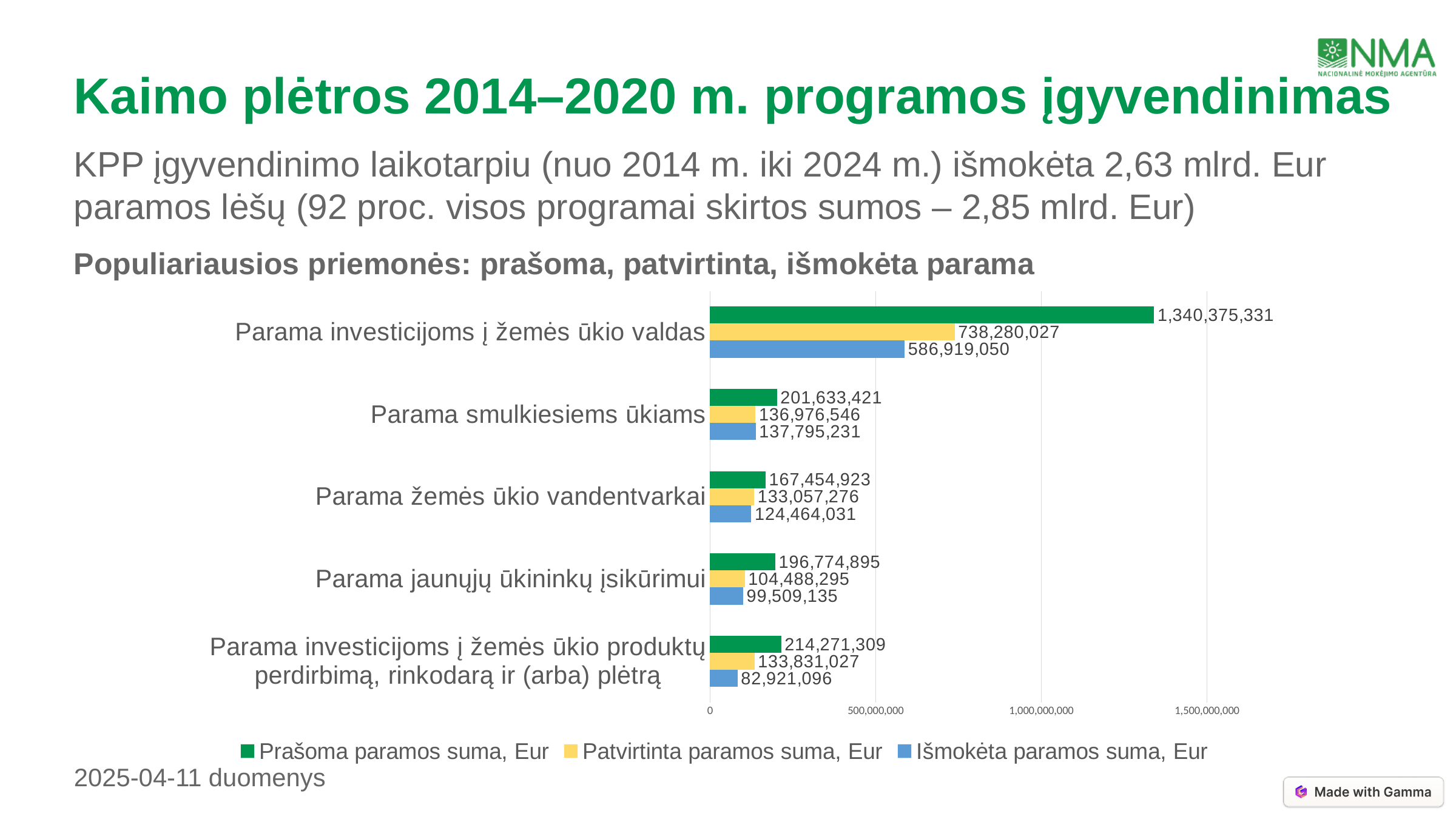
What type of chart is shown on the slide? bar chart What is the Patvirtinta paramos suma, Eur for Parama žemės ūkio vandentvarkai? 133,057,276 Is the Patvirtinta paramos suma for Parama investicijoms į žemės ūkio valdas greater or less than 1,000,000,000? less What is the Prašoma paramos suma, Eur for Parama investicijoms į žemės ūkio valdas? 1,340,375,331 Which colour represents the Išmokėta paramos suma, Eur series in the chart? blue How many series does the chart legend list? 3 Which category has the highest Prašoma paramos suma, Eur? Parama investicijoms į žemės ūkio valdas How many categories (measures) are shown in the chart? 5 What is the Išmokėta paramos suma, Eur for Parama jaunųjų ūkininkų įsikūrimui? 99,509,135 What is the difference between the Prašoma and Patvirtinta paramos suma for Parama investicijoms į žemės ūkio valdas? 602,095,304 Which is larger: the Prašoma paramos suma for Parama investicijoms į žemės ūkio produktų perdirbimą, rinkodarą ir (arba) plėtrą or for Parama žemės ūkio vandentvarkai? Parama investicijoms į žemės ūkio produktų perdirbimą, rinkodarą ir (arba) plėtrą Which category has the lowest Išmokėta paramos suma, Eur? Parama investicijoms į žemės ūkio produktų perdirbimą, rinkodarą ir (arba) plėtrą